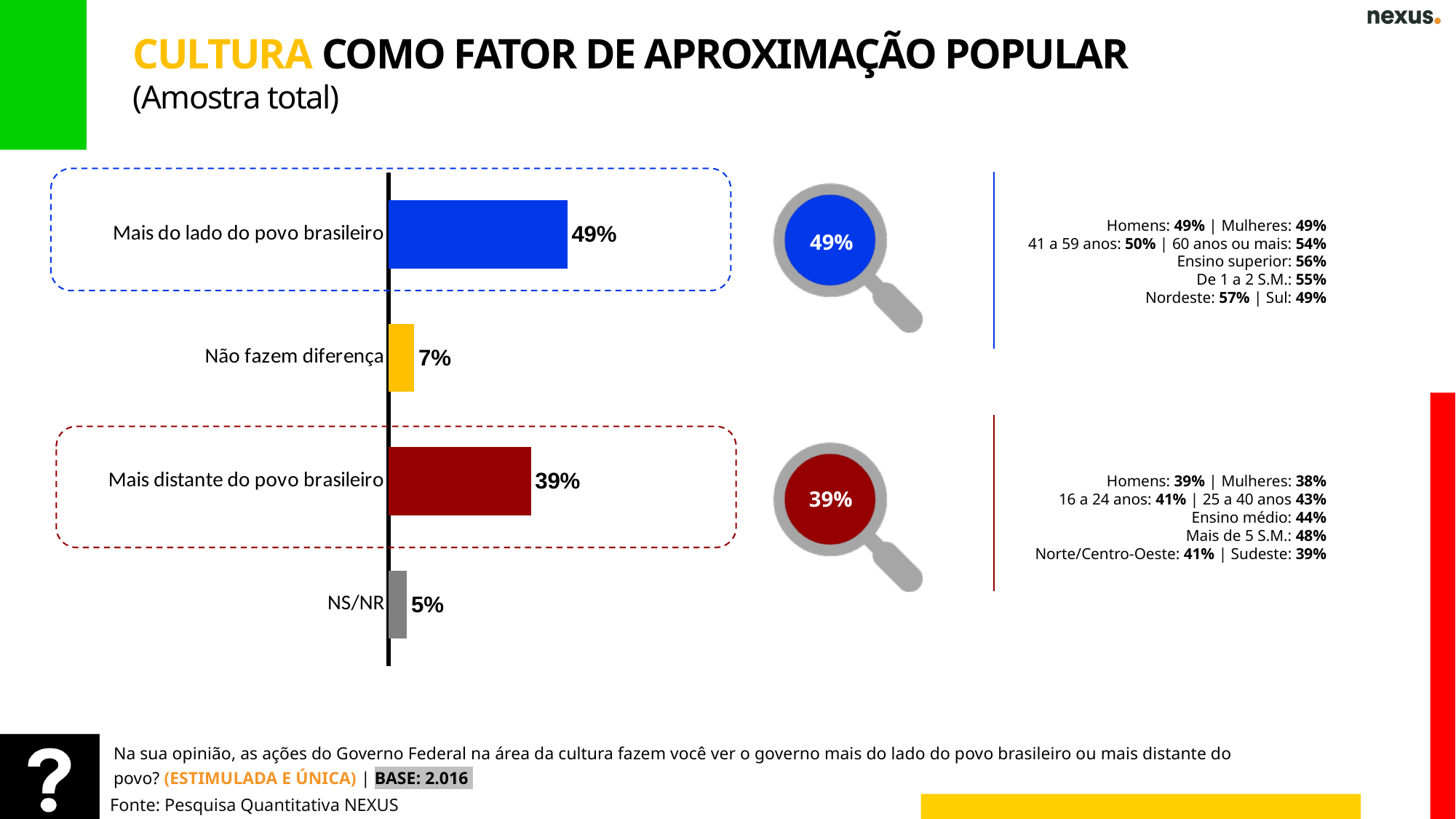
What is the value for "Mais do lado do povo brasileiro"? 49% What is the base (sample size) shown on the slide? 2.016 Which is larger: "Não fazem diferença" or "NS/NR"? Não fazem diferença What is the value for "Não fazem diferença"? 7% What is the difference between "Mais do lado do povo brasileiro" and "Mais distante do povo brasileiro"? 10 percentage points What is the value for "NS/NR"? 5% What kind of chart is shown on the slide? Bar chart What colour is the bar for "Mais distante do povo brasileiro"? Dark red How many categories are shown in the chart? 4 What is the value for "Mais distante do povo brasileiro"? 39% Which category has the highest value? Mais do lado do povo brasileiro Which category has the lowest value? NS/NR